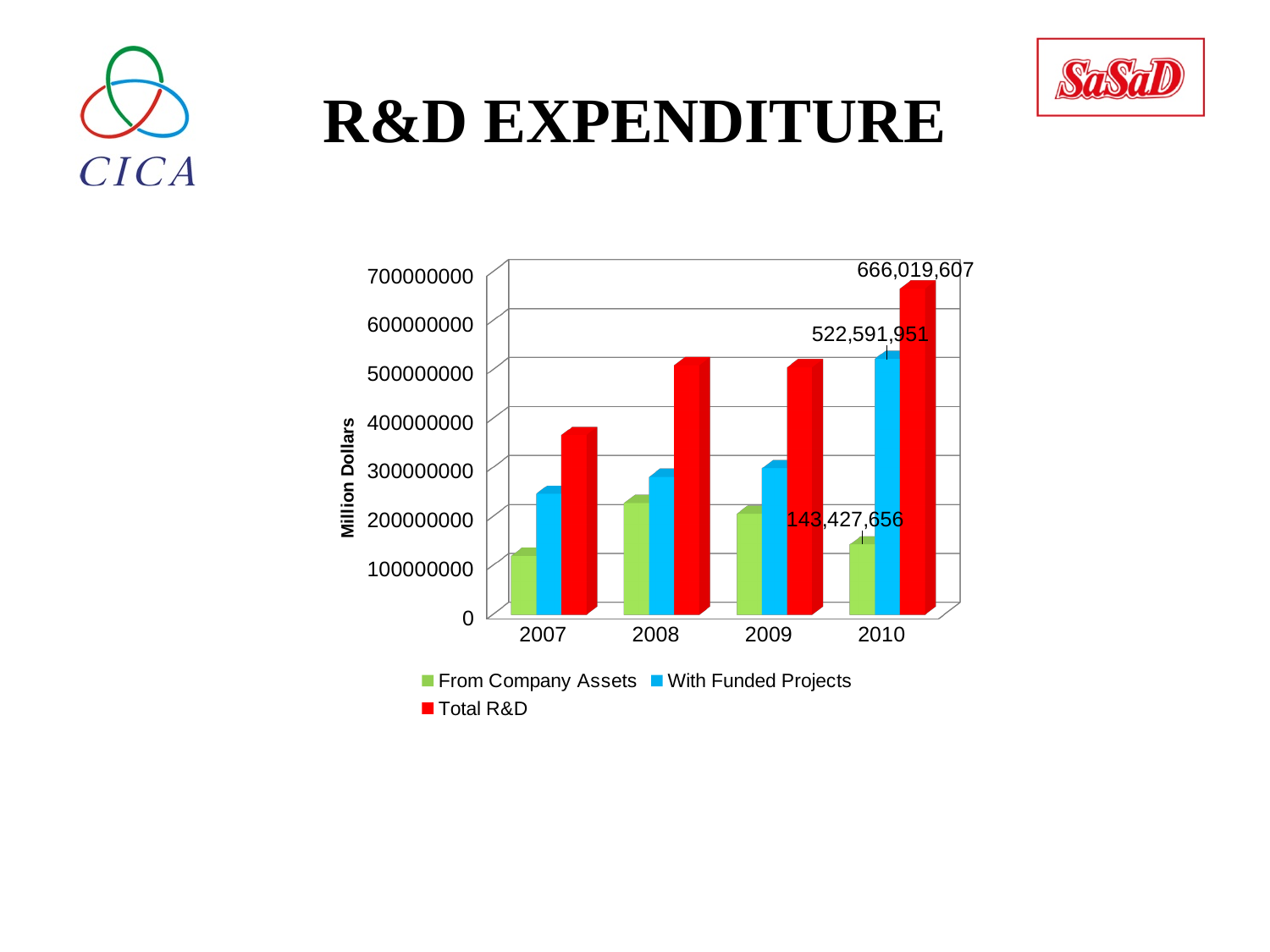
How many series does the legend list? 3 Is the value of With Funded Projects for 2007 greater or less than 300000000? less What is the difference between Total R&D and With Funded Projects in 2010? 143,427,656 What kind of chart is shown on the slide? bar chart What is the value of Total R&D for 2010? 666,019,607 How many years are shown on the x axis? 4 What is the value of From Company Assets for 2010? 143,427,656 What is the value of With Funded Projects for 2010? 522,591,951 In which year is Total R&D highest? 2010 In which year is With Funded Projects lowest? 2007 Is the value of Total R&D for 2007 greater or less than 400000000? less Which is larger, Total R&D in 2008 or Total R&D in 2010? 2010